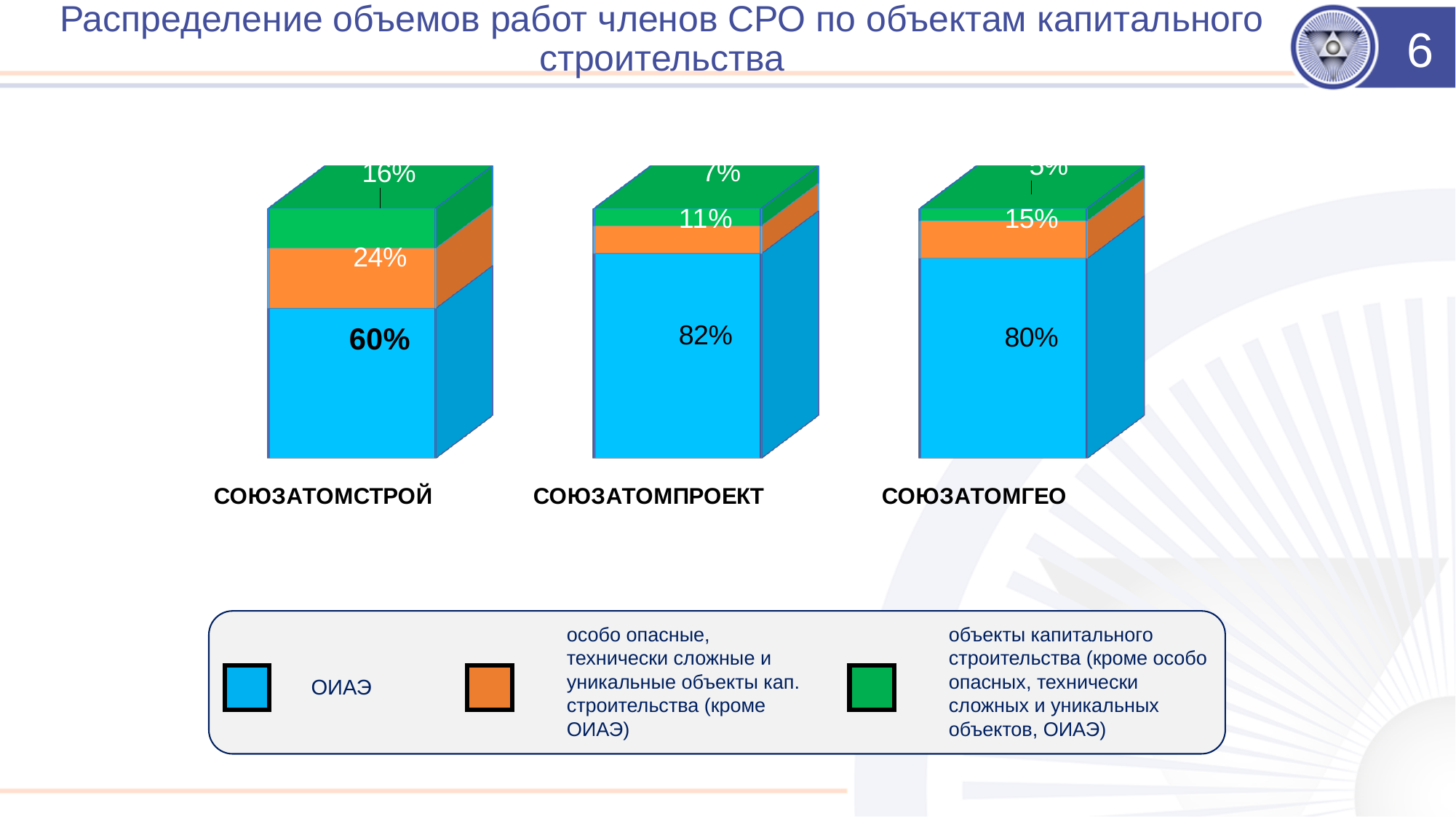
What is the share of the green segment (объекты капитального строительства, кроме особо опасных) for СОЮЗАТОМСТРОЙ? 16% What is the share of особо опасные, технически сложные и уникальные объекты (orange segment) for СОЮЗАТОМГЕО? 15% What is the share of особо опасные, технически сложные и уникальные объекты (orange segment) for СОЮЗАТОМСТРОЙ? 24% How many organizations (bars) are shown in the chart? 3 What is the ОИАЭ share for СОЮЗАТОМГЕО? 80% How many series does the legend list? 3 What is the ОИАЭ share for СОЮЗАТОМПРОЕКТ? 82% What is the ОИАЭ share for СОЮЗАТОМСТРОЙ? 60% Which organization has the lowest ОИАЭ share? СОЮЗАТОМСТРОЙ What is the difference between the ОИАЭ shares of СОЮЗАТОМПРОЕКТ and СОЮЗАТОМСТРОЙ? 22 percentage points What is the share of the green segment (объекты капитального строительства, кроме особо опасных) for СОЮЗАТОМПРОЕКТ? 7% Which organization has the highest ОИАЭ share? СОЮЗАТОМПРОЕКТ